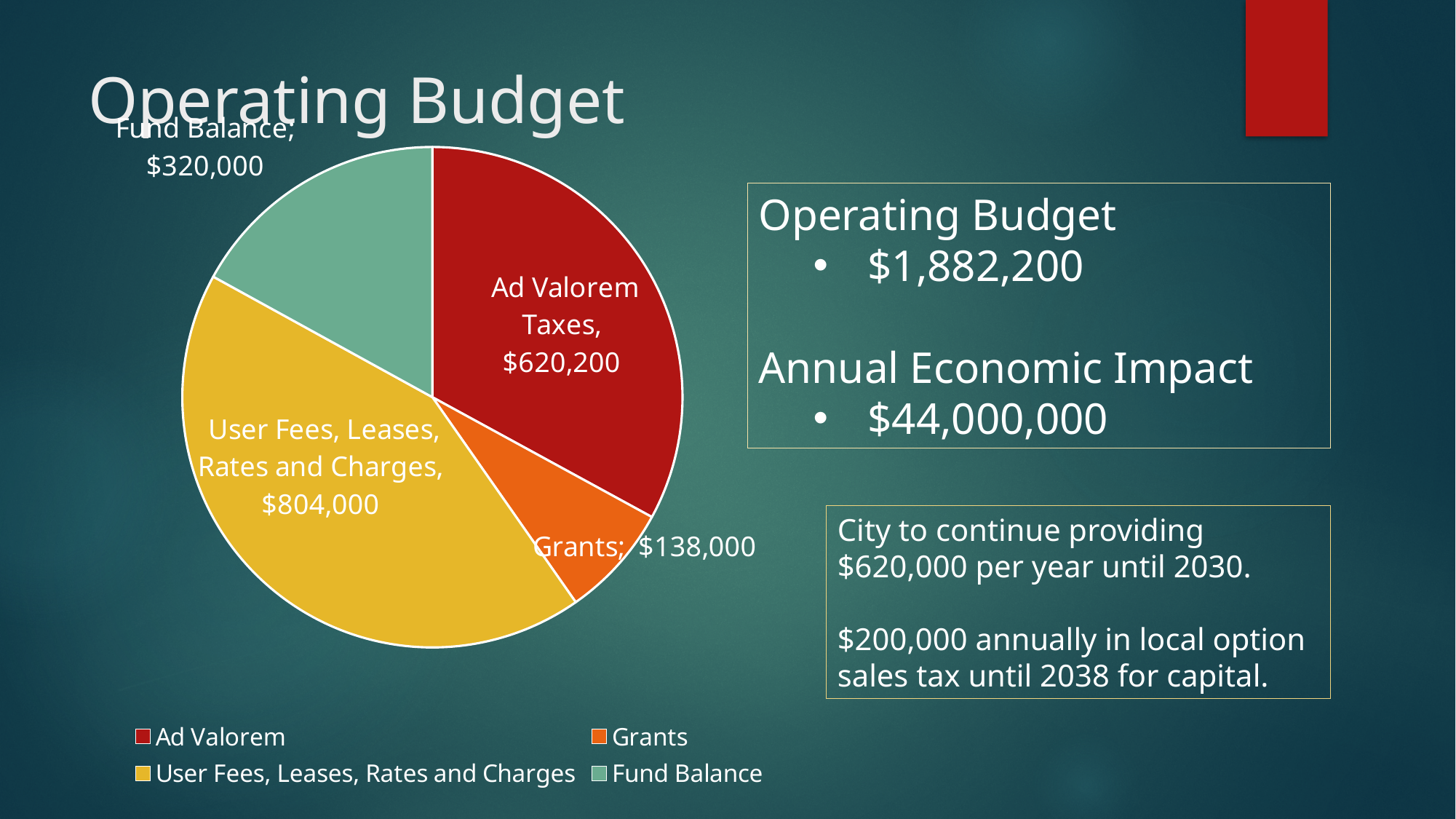
What colour is the Grants slice in the pie chart? Orange Which category has the largest slice of the pie? User Fees, Leases, Rates and Charges How many slices does the pie chart have? 4 What is the value of the User Fees, Leases, Rates and Charges slice? $804,000 What is the value of the Grants slice? $138,000 Which is larger, the Fund Balance slice or the Grants slice? Fund Balance What is the value of the Ad Valorem Taxes slice? $620,200 What is the value of the Fund Balance slice? $320,000 What is the difference between the User Fees, Leases, Rates and Charges value and the Ad Valorem Taxes value? $183,800 What is the difference between the Fund Balance value and the Grants value? $182,000 Which category has the smallest slice of the pie? Grants What type of chart is shown on the slide? Pie chart